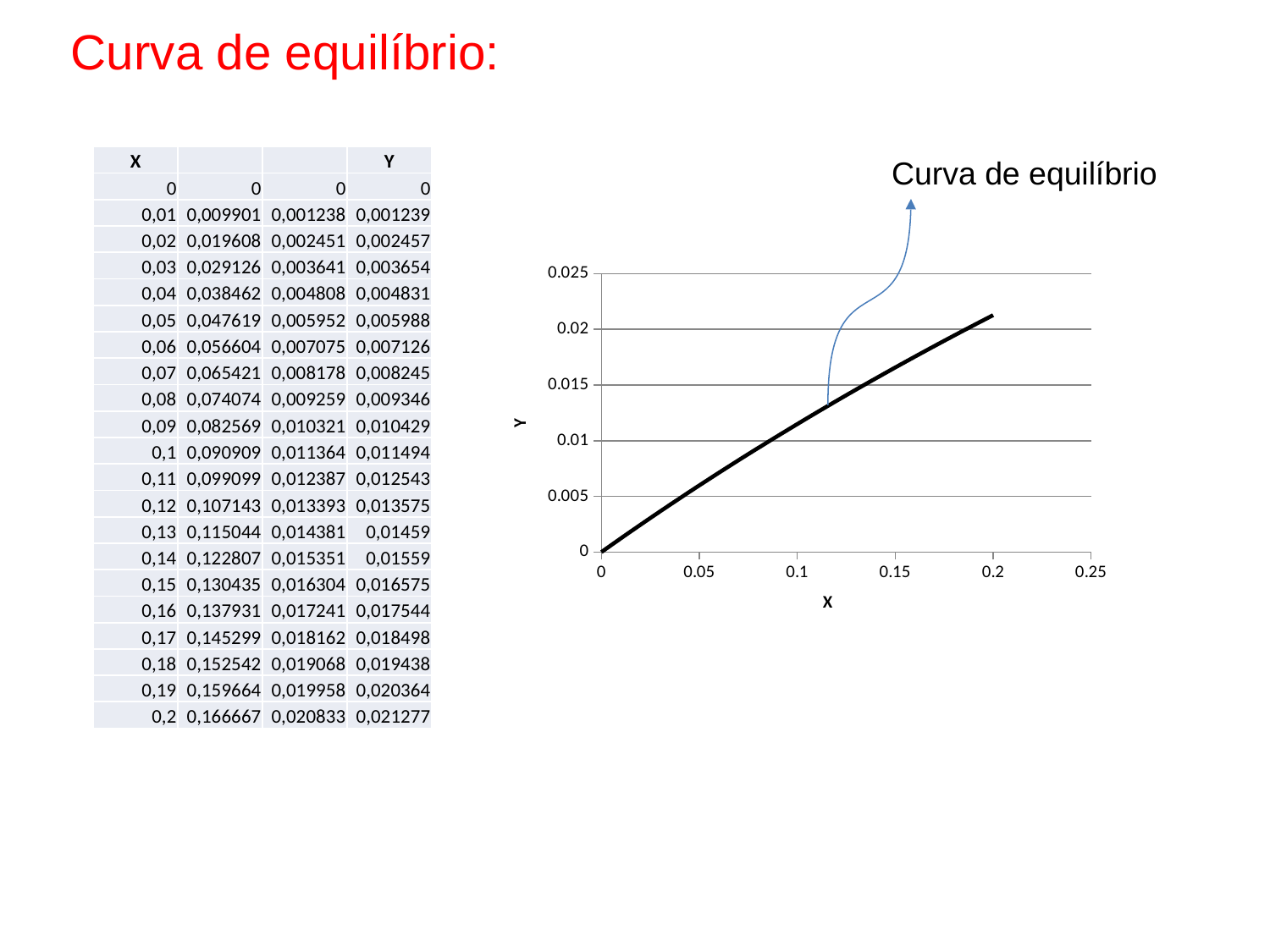
Does the value of Y rise or fall as X increases along the x axis? rise What label is given to the curve by the annotation on the chart? Curva de equilíbrio Is the value of Y at X = 0.1 greater or less than 0.01? greater Is the value of Y at X = 0.15 greater or less than 0.015? greater At which X value does the curve reach its highest Y value? 0.2 Which is larger: the value of Y at X = 0.05 or at X = 0.15? X = 0.15 Is the value of Y at X = 0.1 greater or less than 0.015? less What kind of chart is shown on the slide? line chart At which X value does the curve have its lowest Y value? 0 What is the value of Y at X = 0 on the chart? 0